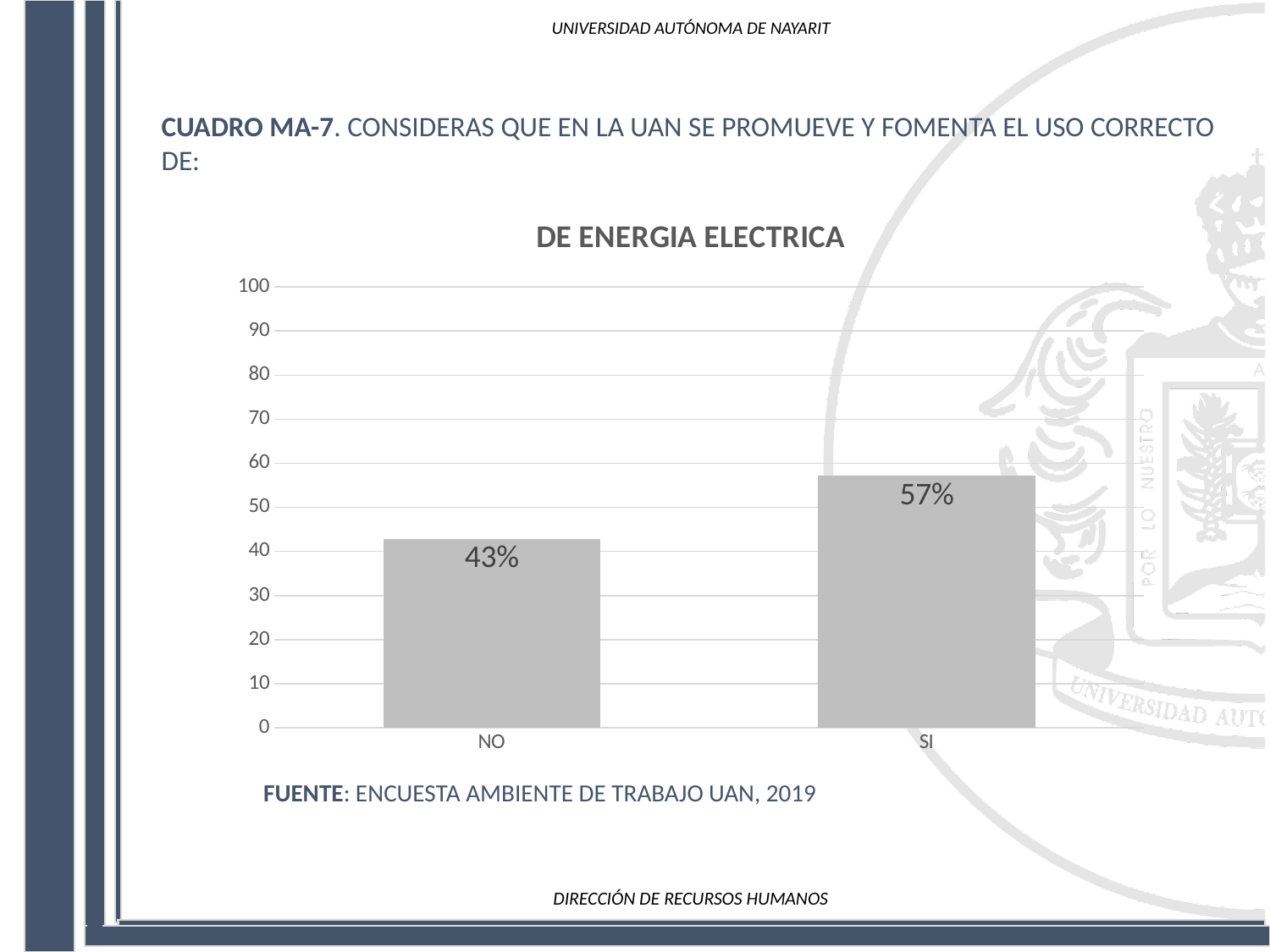
Is the value for SI greater or less than 50? greater What is the value for NO? 43% Which category has the lowest value? NO What is the value for SI? 57% What is the difference between the values for SI and NO? 14% Which category has the highest value? SI Which is larger, the value for NO or the value for SI? SI What is the maximum value shown on the y axis? 100 How many categories are shown on the x axis? 2 Is the value for NO greater or less than 50? less What kind of chart is shown? bar chart What is the title of the chart? DE ENERGIA ELECTRICA